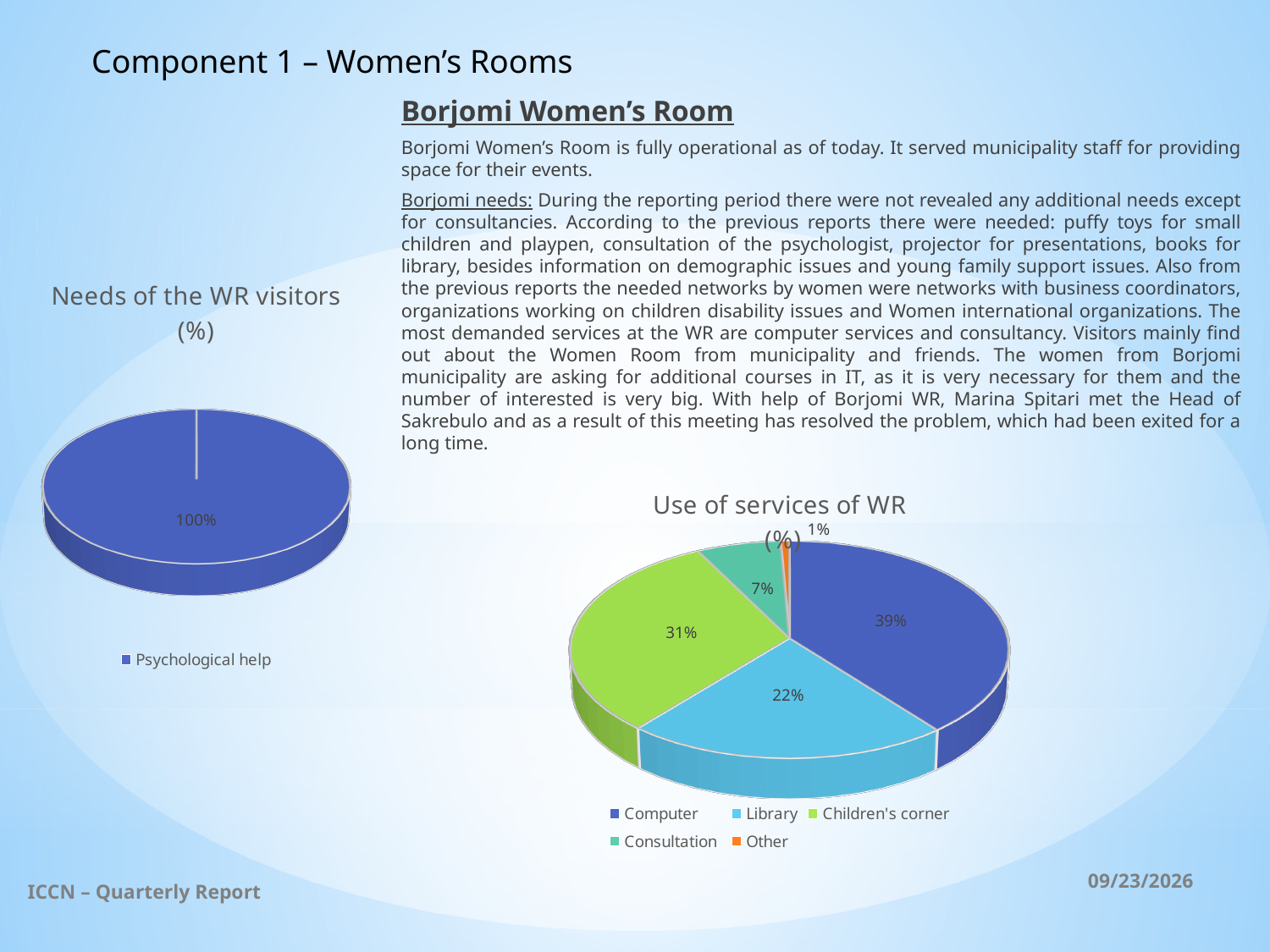
In the 'Use of services of WR (%)' chart, what share does Library have? 22% In the 'Use of services of WR (%)' chart, which service has the smallest share? Other In the 'Needs of the WR visitors (%)' chart, what share does Psychological help have? 100% In the 'Use of services of WR (%)' chart, which is larger, Children's corner or Library? Children's corner In the 'Use of services of WR (%)' chart, what share does Consultation have? 7% How many categories does the legend of the 'Use of services of WR (%)' chart list? 5 What kind of chart is the 'Needs of the WR visitors (%)' chart? Pie chart In the 'Use of services of WR (%)' chart, which service has the largest share? Computer In the 'Use of services of WR (%)' chart, what share does Computer have? 39% In the 'Use of services of WR (%)' chart, what is the difference between the Computer and Library shares? 17% How many entries does the legend of the 'Needs of the WR visitors (%)' chart list? 1 In the 'Use of services of WR (%)' chart, what share does Children's corner have? 31%